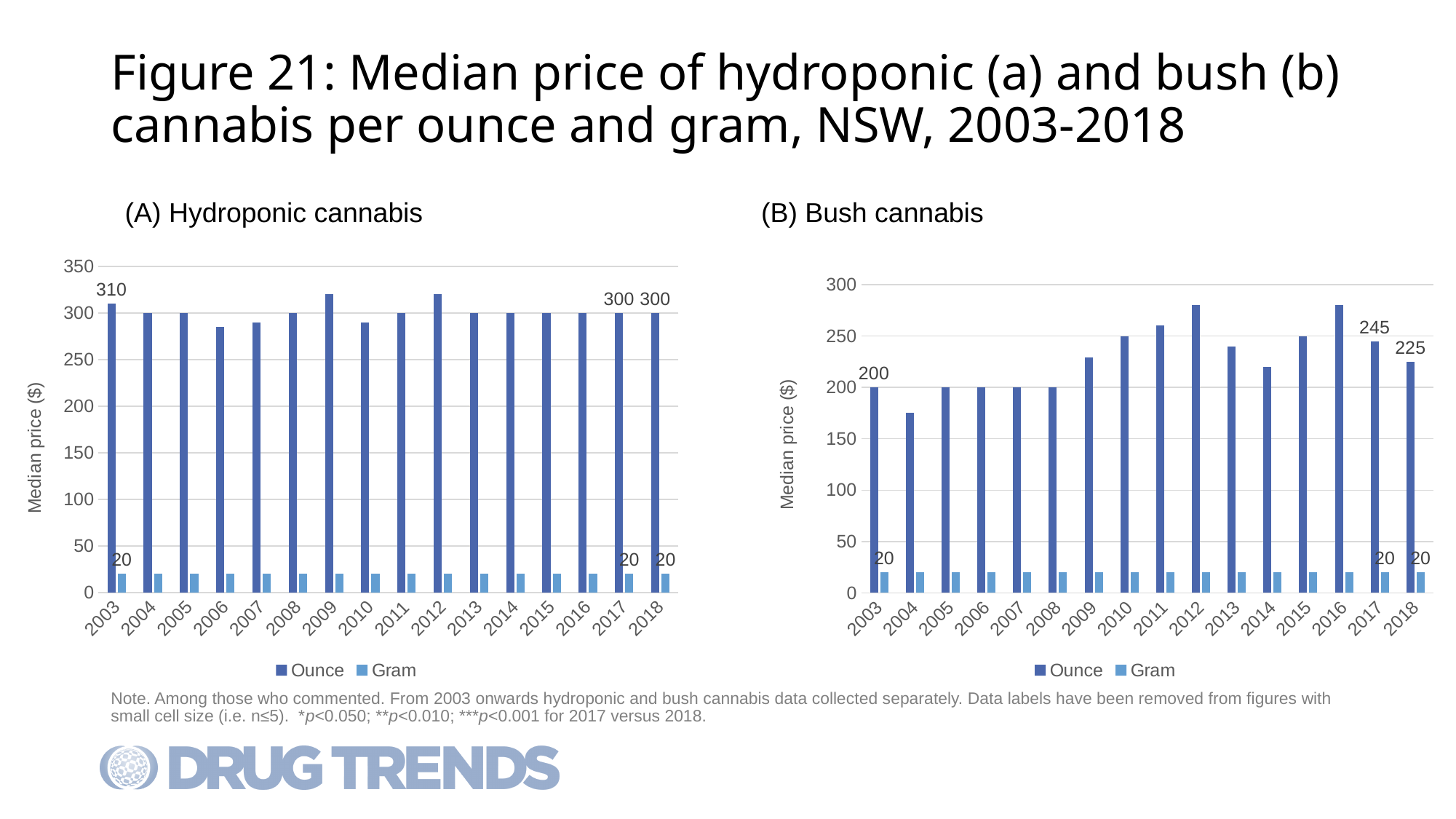
In the (A) Hydroponic cannabis chart, what is the median price per ounce in 2003? 310 In the (A) Hydroponic cannabis chart, what is the difference between the median ounce price in 2003 and in 2018? 10 In the (B) Bush cannabis chart, by how much did the median ounce price fall from 2017 to 2018? 20 In the (B) Bush cannabis chart, what is the median price per gram in 2018? 20 In the (B) Bush cannabis chart, which year has the lowest median price per ounce? 2004 In the (A) Hydroponic cannabis chart, is the median ounce price in 2009 greater or less than 300? greater How many series does the legend of the (B) Bush cannabis chart list? 2 How many years are shown on the x axis of the (A) Hydroponic cannabis chart? 16 Which is larger: the 2003 median ounce price for hydroponic cannabis in chart (A) or for bush cannabis in chart (B)? Hydroponic cannabis (A) In the (A) Hydroponic cannabis chart, what is the median price per ounce in 2018? 300 In the (B) Bush cannabis chart, what is the median price per ounce in 2017? 245 In the (B) Bush cannabis chart, is the median ounce price in 2004 greater or less than 200? less